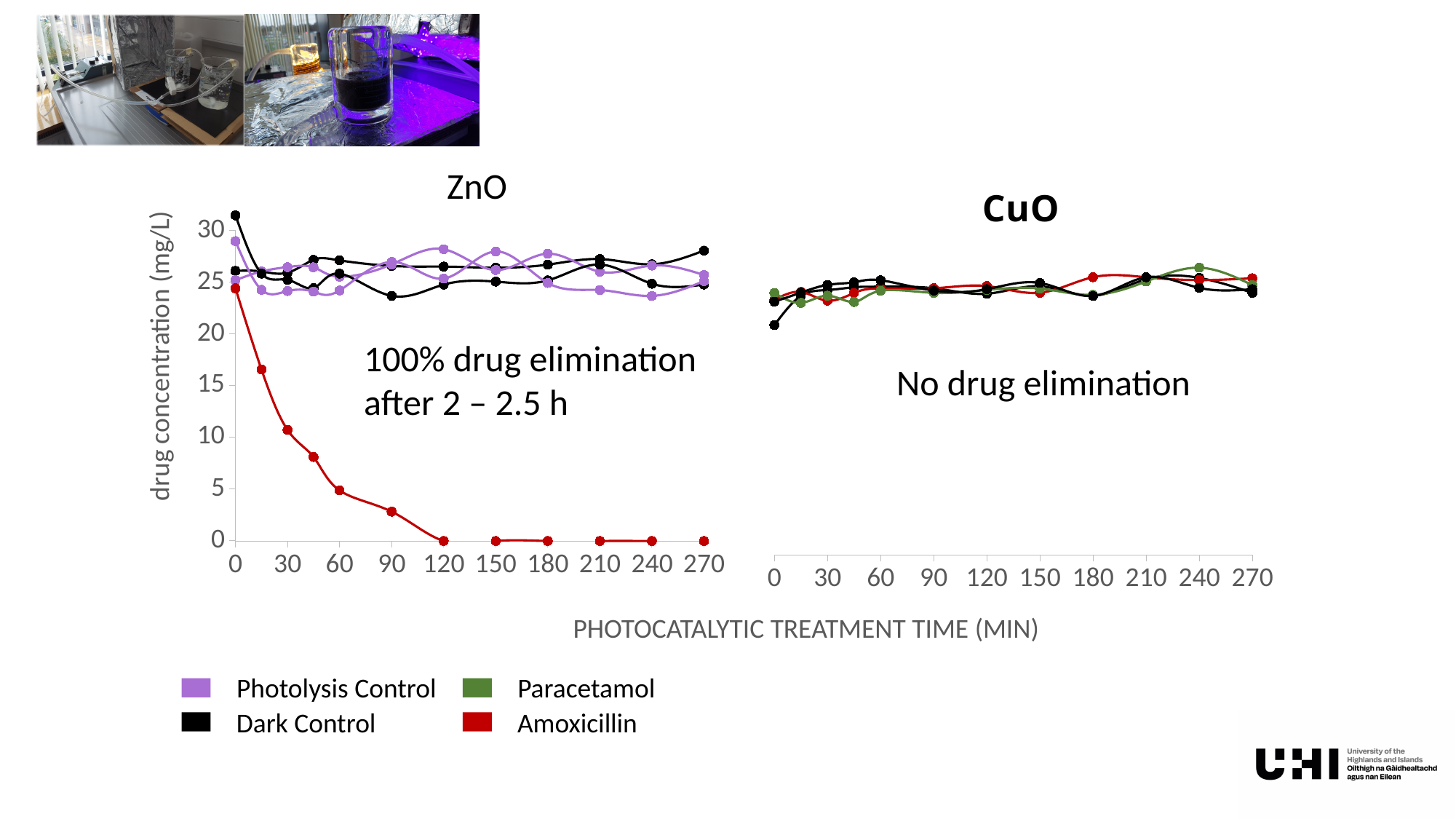
In the CuO chart, is the Amoxicillin value at 180 min greater or less than 20? greater How many tick labels are shown on the x axis of the CuO chart? 10 In the ZnO chart, is the Amoxicillin value at 0 min greater or less than 20? greater In the ZnO chart, is the Amoxicillin value at 15 min greater or less than 15? greater What is the shared x-axis label beneath the two charts? PHOTOCATALYTIC TREATMENT TIME (MIN) In the ZnO chart, does the Amoxicillin concentration rise or fall as treatment time increases? fall What kind of chart is the ZnO chart? line chart How many series does the legend list? 4 In the ZnO chart, what is the Amoxicillin concentration at 120 min? 0 What is the label of the y axis on the ZnO chart? drug concentration (mg/L) In the ZnO chart, which is larger at 270 min: Amoxicillin or Dark Control? Dark Control